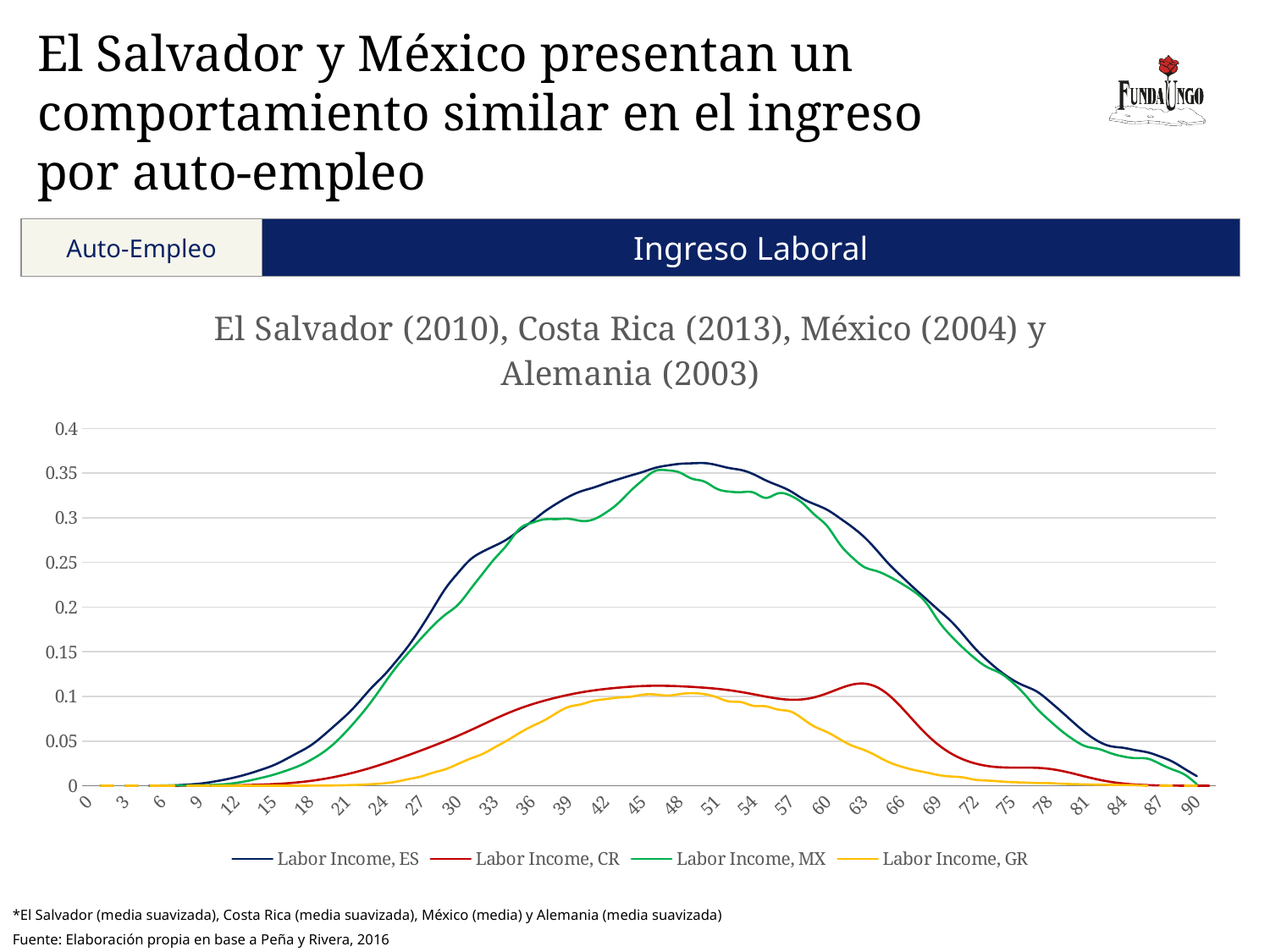
Is the value for Labor Income, CR at age 48 greater or less than 0.15? less Is the value for Labor Income, ES at age 48 greater or less than 0.3? greater What kind of chart is shown on the slide? Line chart Which series reaches the highest peak value? Labor Income, ES Does the Labor Income, ES line rise or fall between age 51 and age 90? Fall What are the four series named in the legend? Labor Income, ES; Labor Income, CR; Labor Income, MX; Labor Income, GR Is the value for Labor Income, MX at age 30 greater or less than 0.15? greater What is the title of the chart? El Salvador (2010), Costa Rica (2013), México (2004) y Alemania (2003) At age 30, which is larger: Labor Income, ES or Labor Income, MX? Labor Income, ES At age 63, which is larger: Labor Income, CR or Labor Income, GR? Labor Income, CR How many series does the legend list? 4 Which series has the lowest peak value? Labor Income, GR